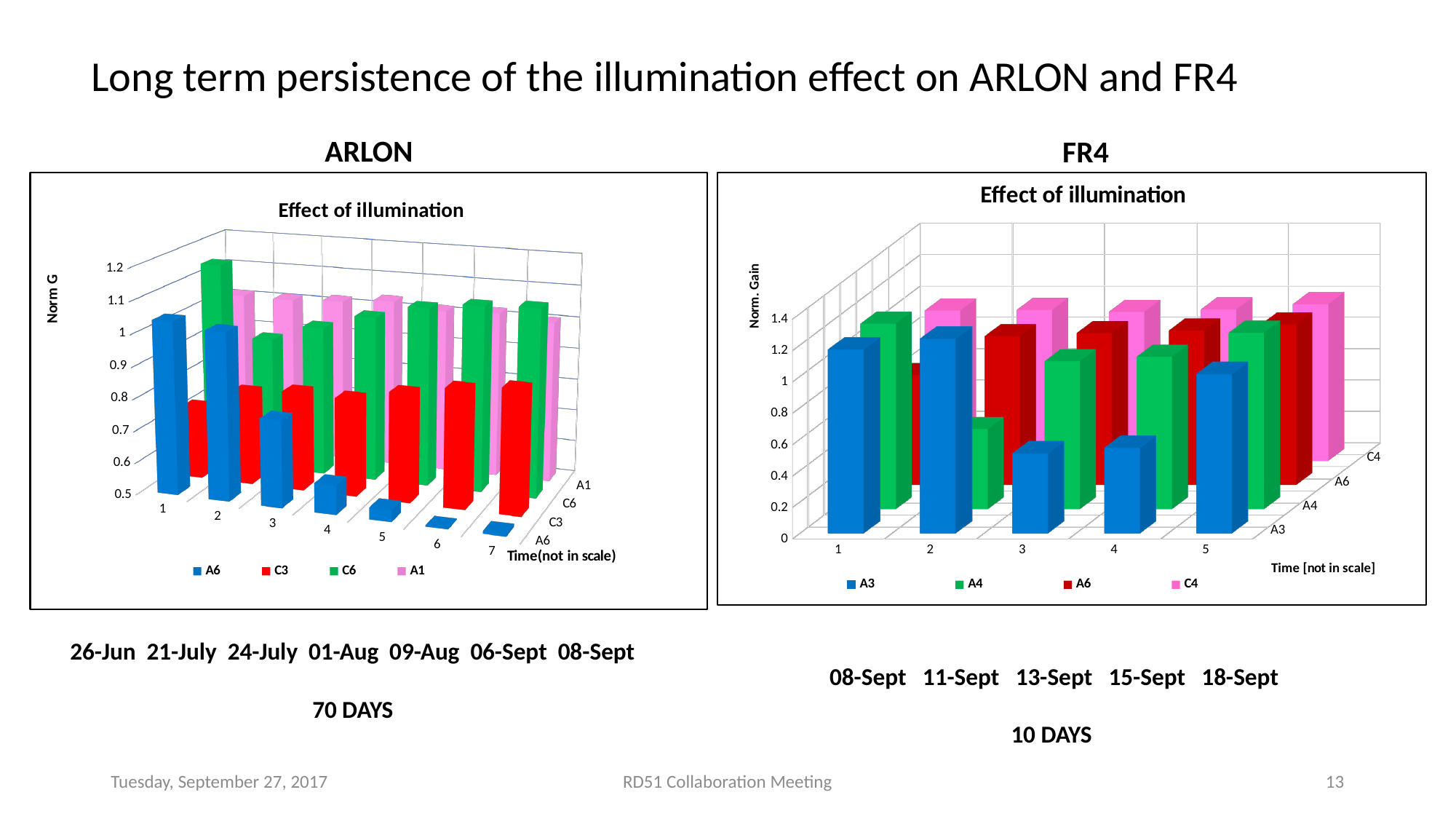
In the ARLON chart, is the value of A6 at time point 7 greater or less than 0.6? less What kind of chart is the ARLON chart on the left? bar chart How many series does the legend of the FR4 chart list? 4 In the ARLON chart, do the values of the A6 series rise or fall from time point 1 to time point 7? fall How many time points are shown on the x axis of the FR4 chart? 5 What is the title of the vertical axis of the FR4 chart? Norm. Gain What kind of chart is the FR4 chart on the right? bar chart Which series are listed in the legend of the FR4 chart? A3, A4, A6, C4 How many time points are shown on the x axis of the ARLON chart? 7 In the FR4 chart, is the value of A3 at time point 3 greater or less than 0.8? less How many series does the legend of the ARLON chart list? 4 In the FR4 chart, which is larger: the A3 value at time point 2 or the A3 value at time point 3? time point 2